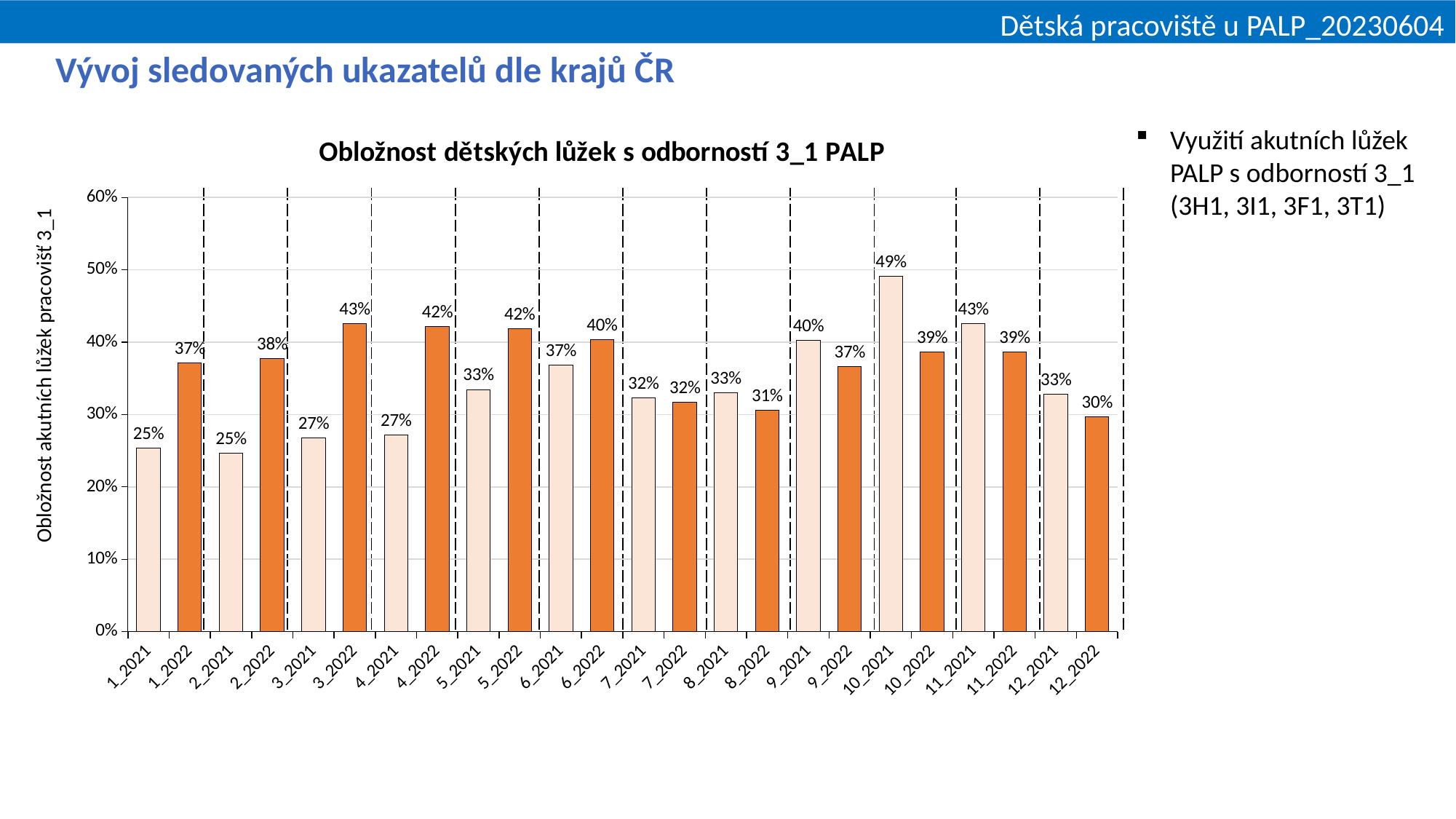
Is the value for 8_2022 greater or less than 40%? less What is the value for 3_2022? 43% Which category has the highest value? 10_2021 What is the value for 12_2022? 30% Which is larger, the value for 9_2021 or 9_2022? 9_2021 What is the value for 10_2021? 49% What is the value for 5_2021? 33% What is the difference between the values for 1_2022 and 1_2021? 12 percentage points What kind of chart is shown? bar chart What is the title of the chart? Obložnost dětských lůžek s odborností 3_1 PALP What is the difference between the values for 10_2021 and 10_2022? 10 percentage points How many bars are shown in the chart? 24